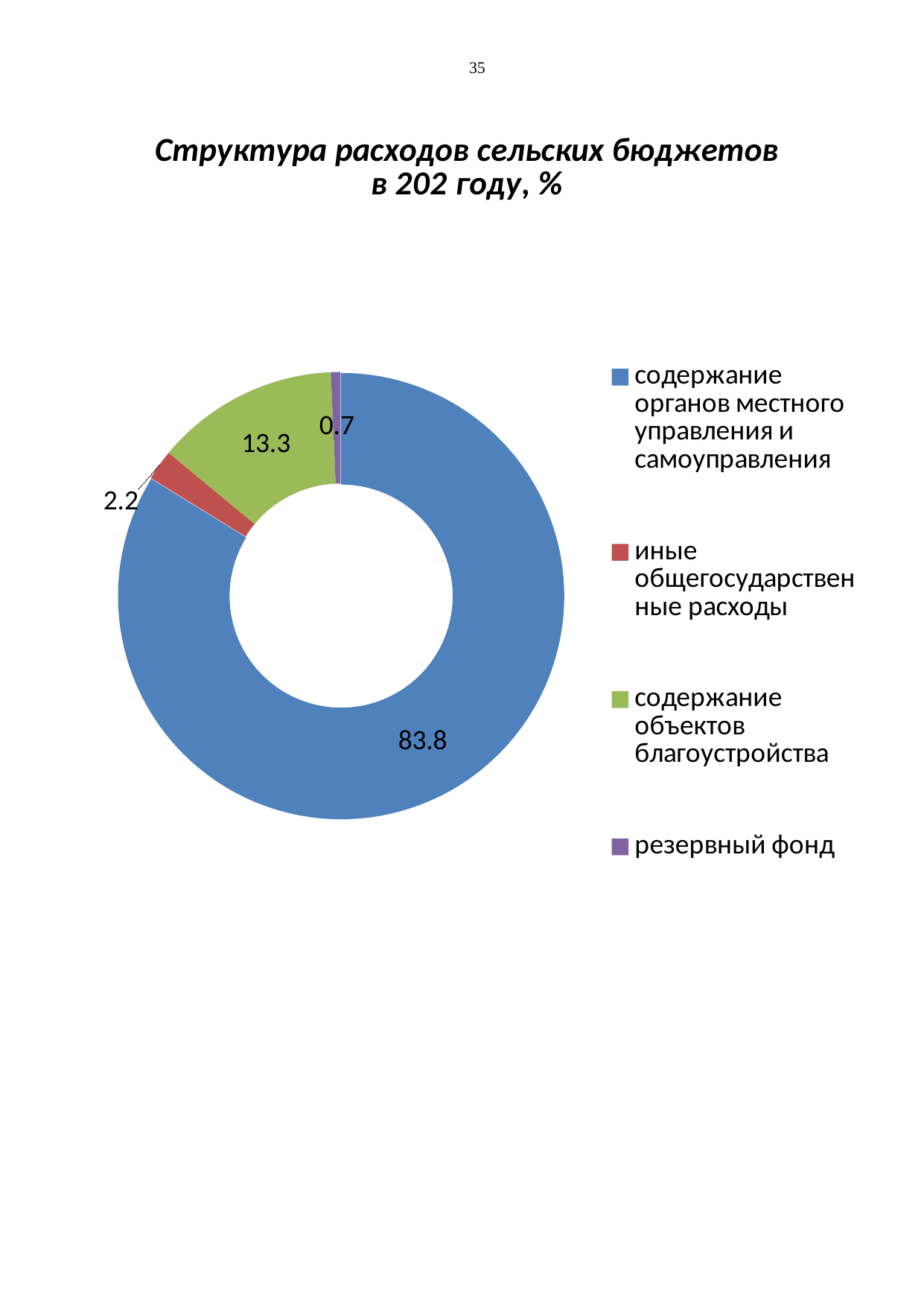
How many categories does the chart show? 4 Which is larger: the share for содержание объектов благоустройства or for иные общегосударственные расходы? содержание объектов благоустройства Which category has the largest share of expenditure? содержание органов местного управления и самоуправления Which category has the smallest share of expenditure? резервный фонд What is the difference between the shares for иные общегосударственные расходы and резервный фонд? 1.5 What value is shown for резервный фонд? 0.7 What share of expenditure is shown for содержание органов местного управления и самоуправления? 83.8 What kind of chart is shown on the slide? doughnut (ring) chart What is the difference between the shares for содержание органов местного управления и самоуправления and содержание объектов благоустройства? 70.5 What is the title of the chart? Структура расходов сельских бюджетов в 202 году, % What value is shown for иные общегосударственные расходы? 2.2 What value is shown for содержание объектов благоустройства? 13.3